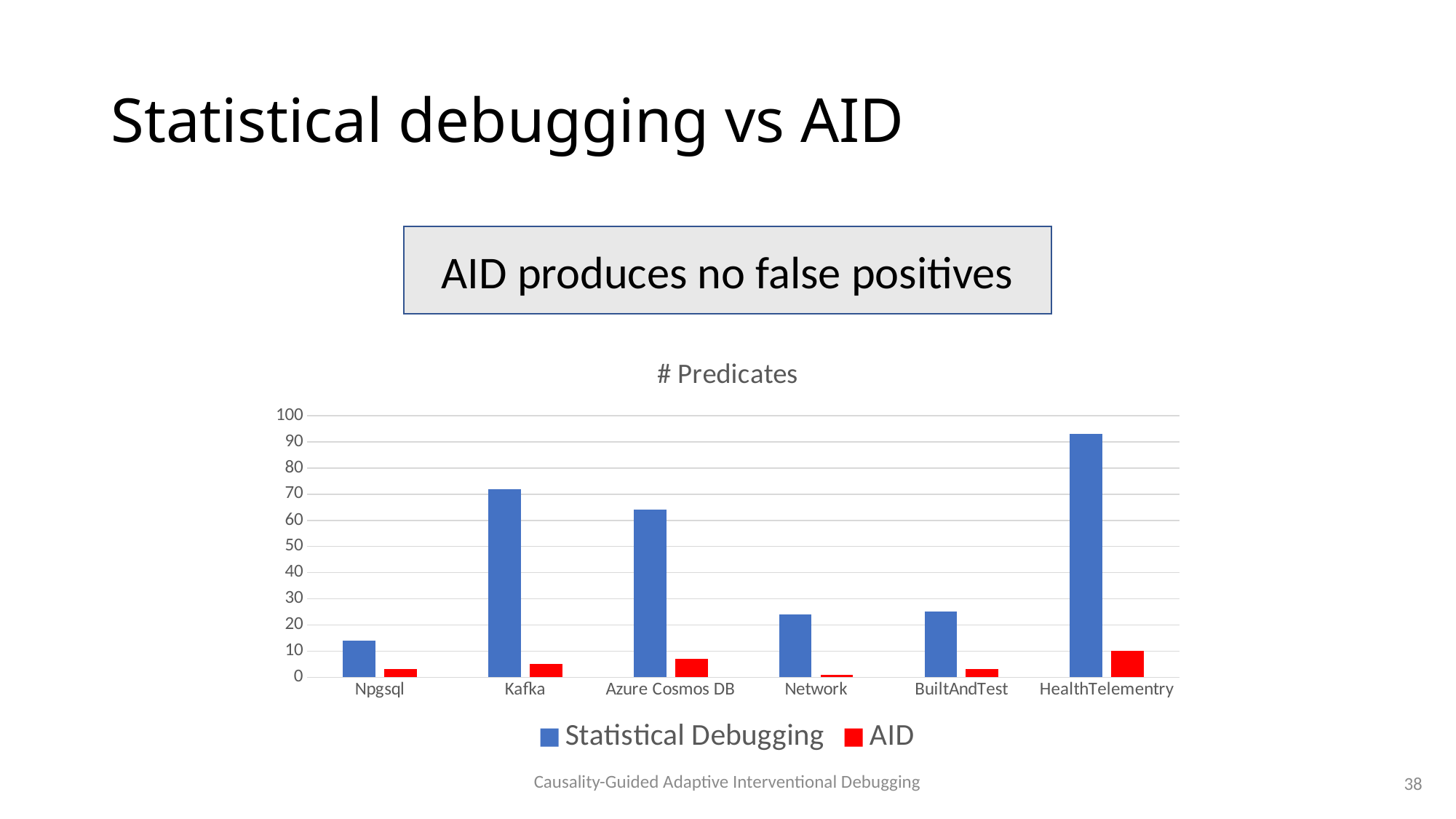
How many categories are shown on the x axis of the "# Predicates" chart? 6 Which category has the lowest AID value? Network How many series does the legend of the "# Predicates" chart list? 2 Is the Statistical Debugging value for HealthTelementry greater or less than 80? greater Which is larger, the Statistical Debugging value for Kafka or for Azure Cosmos DB? Kafka Is the AID value for Azure Cosmos DB greater or less than 10? less Which category has the highest Statistical Debugging value? HealthTelementry What is the title of the chart on the slide? # Predicates Which category has the lowest Statistical Debugging value? Npgsql Which category has the highest AID value? HealthTelementry What kind of chart is shown on the slide? bar chart Is the Statistical Debugging value for Npgsql greater or less than 20? less